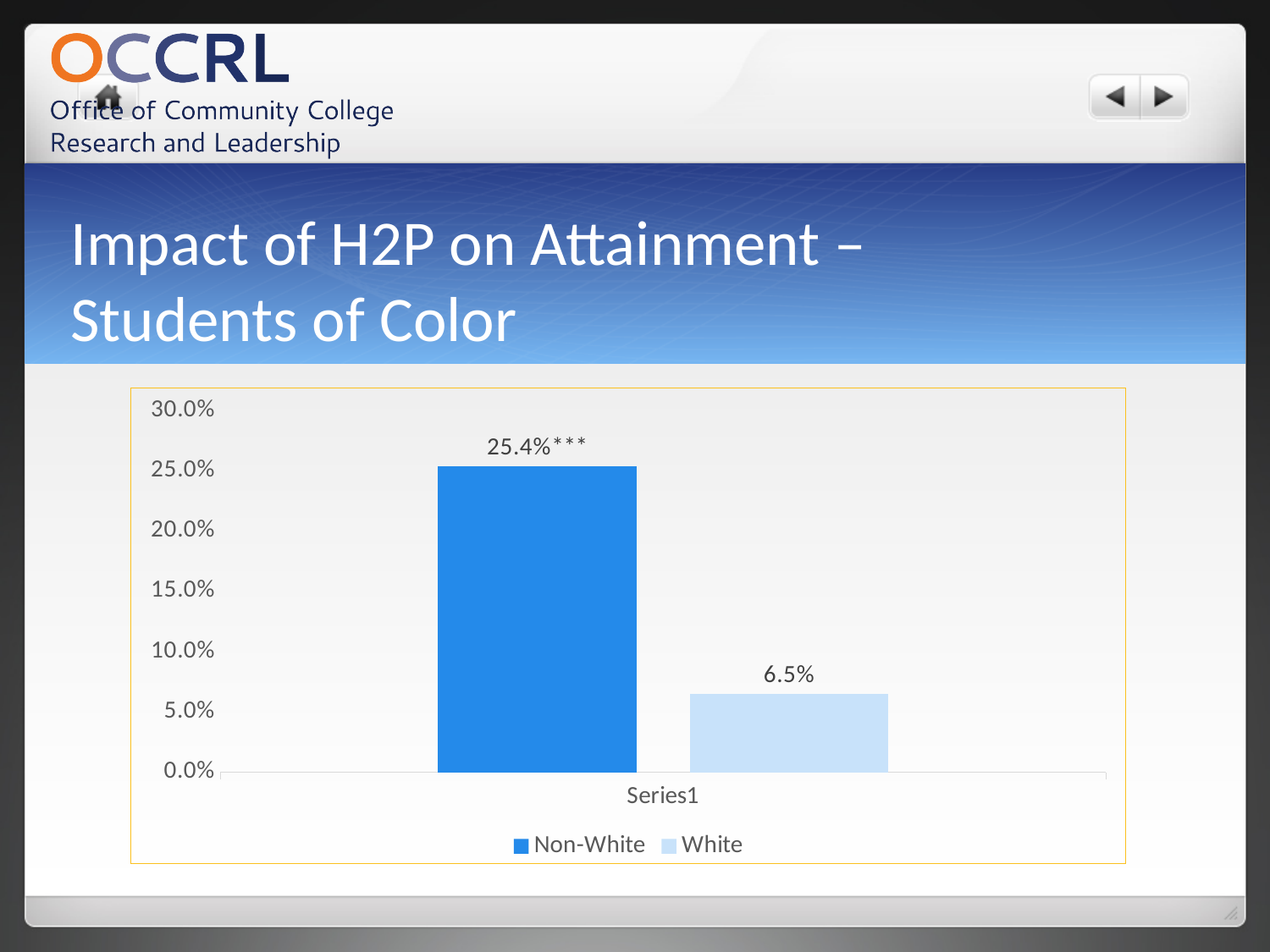
Which series has the lowest value? White Which series has the highest value? Non-White What is the value for Non-White? 25.4% How many series does the legend list? 2 What is the category label shown on the x axis? Series1 Is the value for Non-White greater or less than 20.0%? greater What is the highest value shown on the y axis? 30.0% Which series has the higher value, Non-White or White? Non-White What is the difference between the Non-White and White values? 18.9% What is the value for White? 6.5% What kind of chart is shown on the slide? bar chart Is the value for White greater or less than 10.0%? less